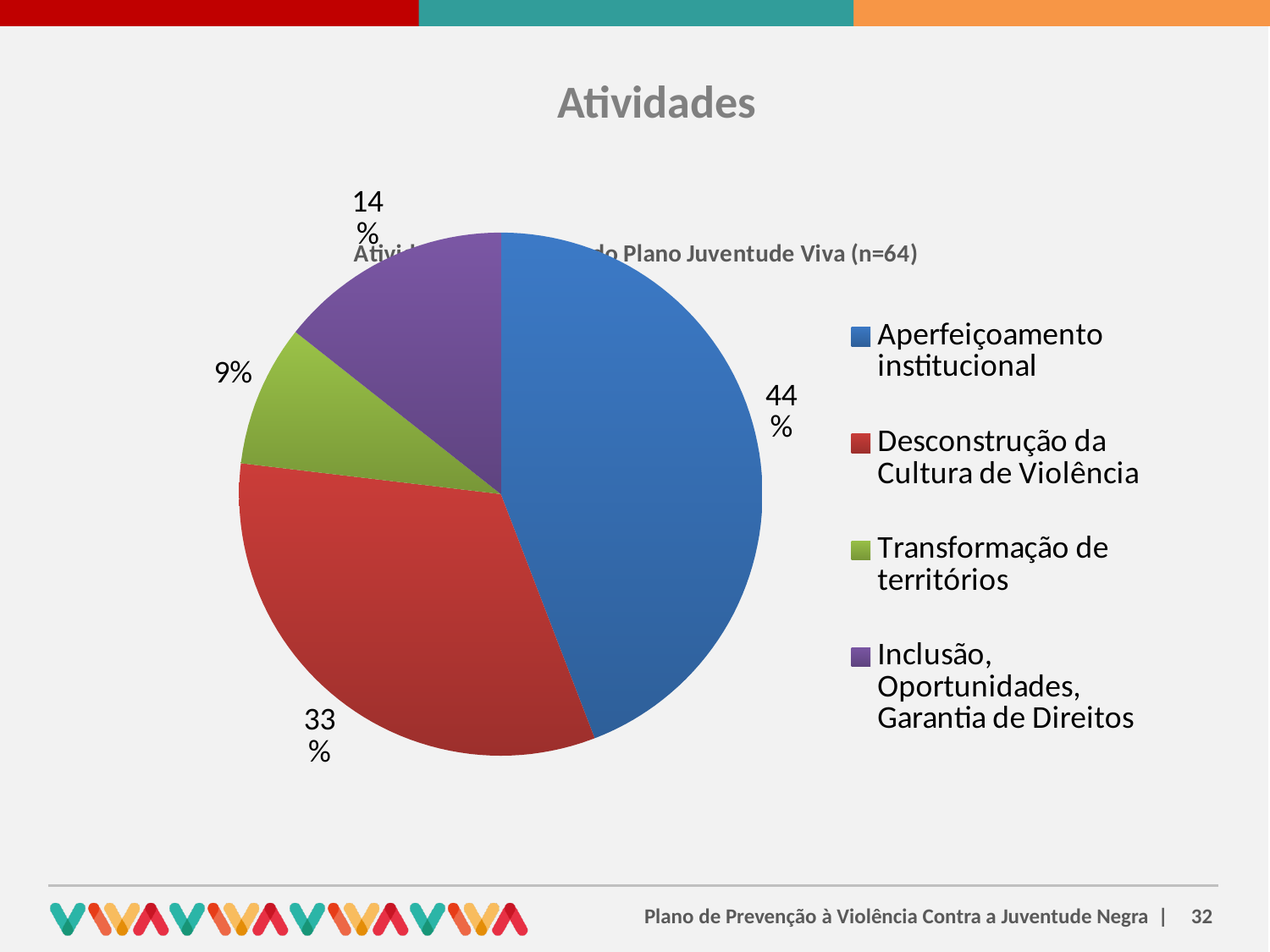
Which is larger: the slice for Inclusão, Oportunidades, Garantia de Direitos or the slice for Transformação de territórios? Inclusão, Oportunidades, Garantia de Direitos How many categories does the pie chart show? 4 What colour is the slice for Desconstrução da Cultura de Violência? red What share of the pie does Desconstrução da Cultura de Violência represent? 33% What kind of chart is shown on the slide? pie chart What is the sample size (n) stated in the chart title? 64 What share of the pie does Inclusão, Oportunidades, Garantia de Direitos represent? 14% What is the difference in percentage points between Aperfeiçoamento institucional and Desconstrução da Cultura de Violência? 11 percentage points Which category has the largest slice of the pie? Aperfeiçoamento institucional What share of the pie does Aperfeiçoamento institucional represent? 44% Which category has the smallest slice of the pie? Transformação de territórios